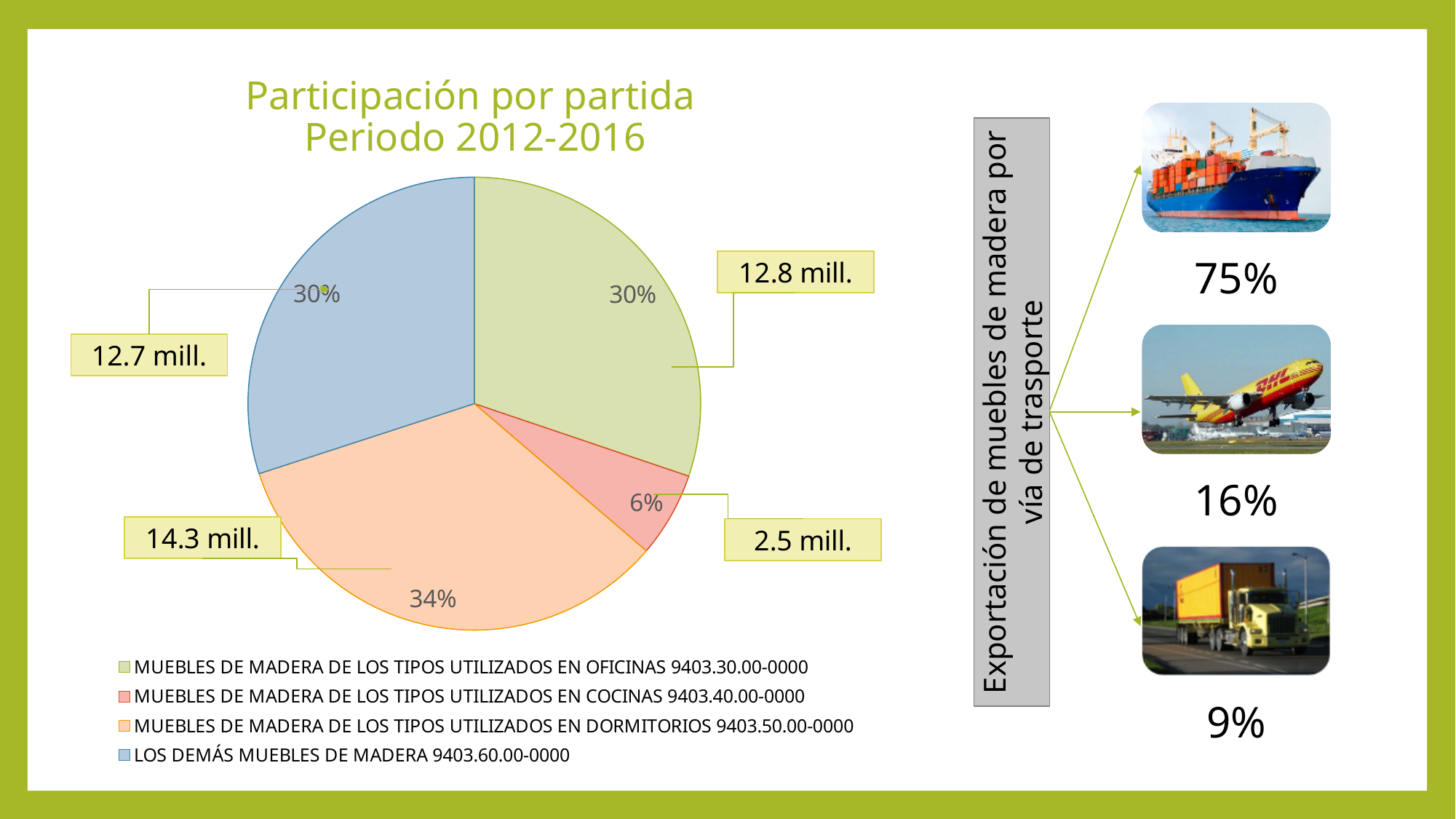
How many entries does the legend of the pie chart list? 4 Which category has the largest slice of the pie? MUEBLES DE MADERA DE LOS TIPOS UTILIZADOS EN DORMITORIOS 9403.50.00-0000 Which category has the smallest slice of the pie? MUEBLES DE MADERA DE LOS TIPOS UTILIZADOS EN COCINAS 9403.40.00-0000 Based on the callout values, which is larger: OFICINAS 9403.30.00-0000 or LOS DEMÁS MUEBLES DE MADERA 9403.60.00-0000? OFICINAS 9403.30.00-0000 What is the title of the pie chart? Participación por partida Periodo 2012-2016 What value is shown in the callout for LOS DEMÁS MUEBLES DE MADERA 9403.60.00-0000? 12.7 mill. What is the difference between the callout values for DORMITORIOS (14.3 mill.) and COCINAS (2.5 mill.)? 11.8 mill. What kind of chart is shown on the slide? Pie chart What value is shown in the callout for MUEBLES DE MADERA DE LOS TIPOS UTILIZADOS EN OFICINAS 9403.30.00-0000? 12.8 mill. What share of the pie does MUEBLES DE MADERA DE LOS TIPOS UTILIZADOS EN COCINAS 9403.40.00-0000 represent? 6% How many slices does the pie chart have? 4 What share of the pie does MUEBLES DE MADERA DE LOS TIPOS UTILIZADOS EN DORMITORIOS 9403.50.00-0000 represent? 34%